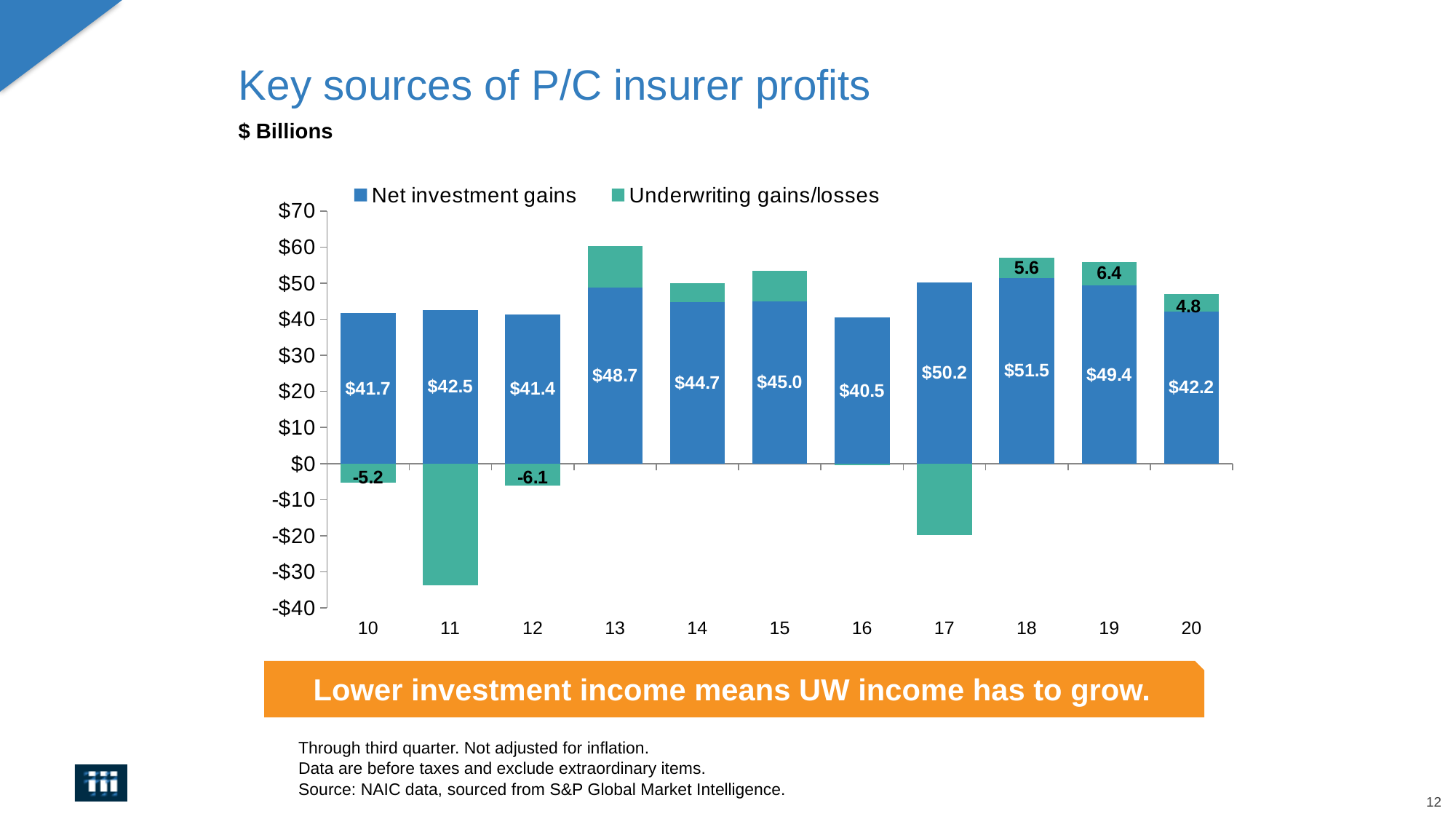
How many series does the legend list? 2 What kind of chart is shown on the slide? Stacked bar chart What is the difference between Net investment gains in 18 and in 20? $9.3 Which year has the lowest Net investment gains? 16 What is the total of the stacked bar for 18? $57.1 Which year has the highest Net investment gains? 18 How many years are shown on the x axis? 11 What is the value of Underwriting gains/losses for 12? -6.1 Is the value of Underwriting gains/losses for 17 greater or less than -$10? less What is the value of Underwriting gains/losses for 19? 6.4 Which is larger, Net investment gains in 14 or in 15? 15 What is the value of Net investment gains for 13? $48.7